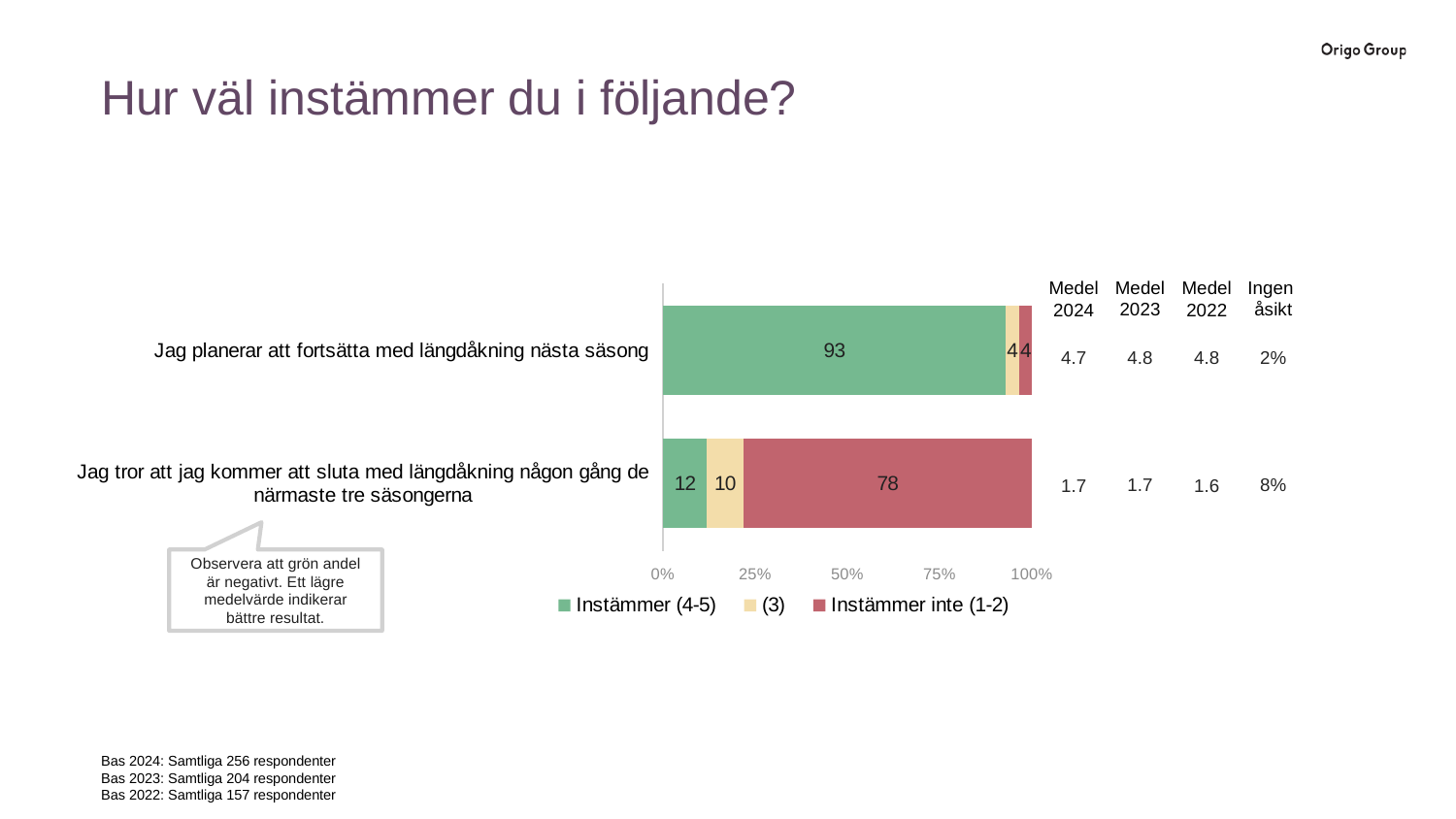
What is the difference between the 'Instämmer (4-5)' values of the two statements? 81 What is the '(3)' value for 'Jag tror att jag kommer att sluta med längdåkning någon gång de närmaste tre säsongerna'? 10 How many series does the legend list? 3 What is the 'Instämmer (4-5)' value for 'Jag tror att jag kommer att sluta med längdåkning någon gång de närmaste tre säsongerna'? 12 Is the 'Instämmer (4-5)' value for 'Jag planerar att fortsätta med längdåkning nästa säsong' greater or less than 75%? greater What is the total of the stacked bar for 'Jag tror att jag kommer att sluta med längdåkning någon gång de närmaste tre säsongerna'? 100 What is the 'Instämmer inte (1-2)' value for 'Jag tror att jag kommer att sluta med längdåkning någon gång de närmaste tre säsongerna'? 78 What is the 'Instämmer (4-5)' value for 'Jag planerar att fortsätta med längdåkning nästa säsong'? 93 What type of chart is shown on the slide? Stacked bar chart Which statement has the higher 'Instämmer (4-5)' value? Jag planerar att fortsätta med längdåkning nästa säsong What is the Medel 2024 value for 'Jag planerar att fortsätta med längdåkning nästa säsong'? 4.7 How many statements (categories) are plotted in the chart? 2